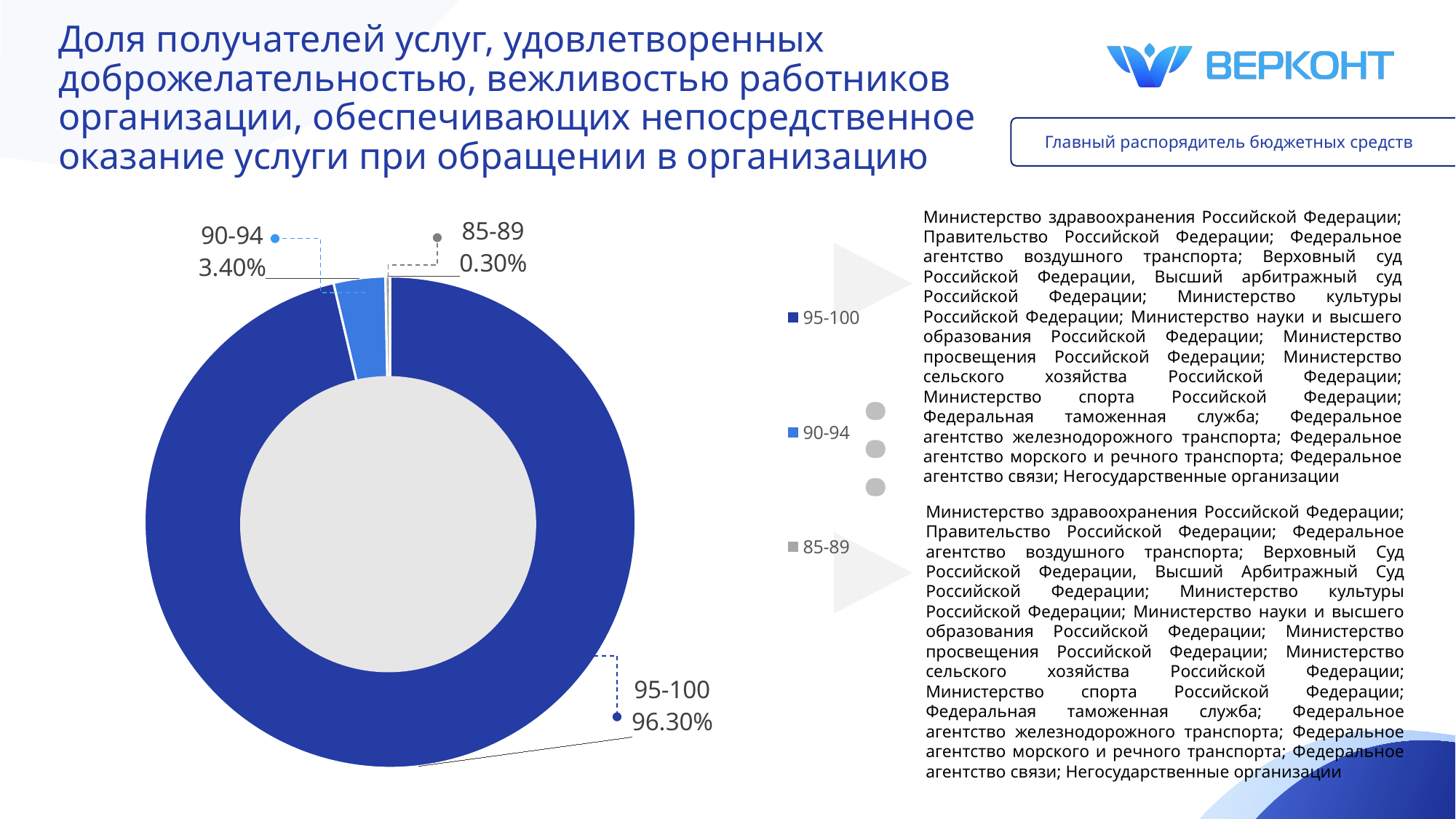
How many slices does the chart have? 3 How many entries does the legend list? 3 What colour is the 90-94 slice in the chart? Light blue What is the value for the 95-100 slice? 96.30% What is the difference between the 90-94 and 85-89 values? 3.10% Which category has the smallest share of the chart? 85-89 What is the value for the 90-94 slice? 3.40% Which category has the largest share of the chart? 95-100 What is the value for the 85-89 slice? 0.30% What kind of chart is shown on the slide? Doughnut chart What is the difference between the 95-100 and 90-94 values? 92.90% Which is larger, the 90-94 slice or the 85-89 slice? 90-94